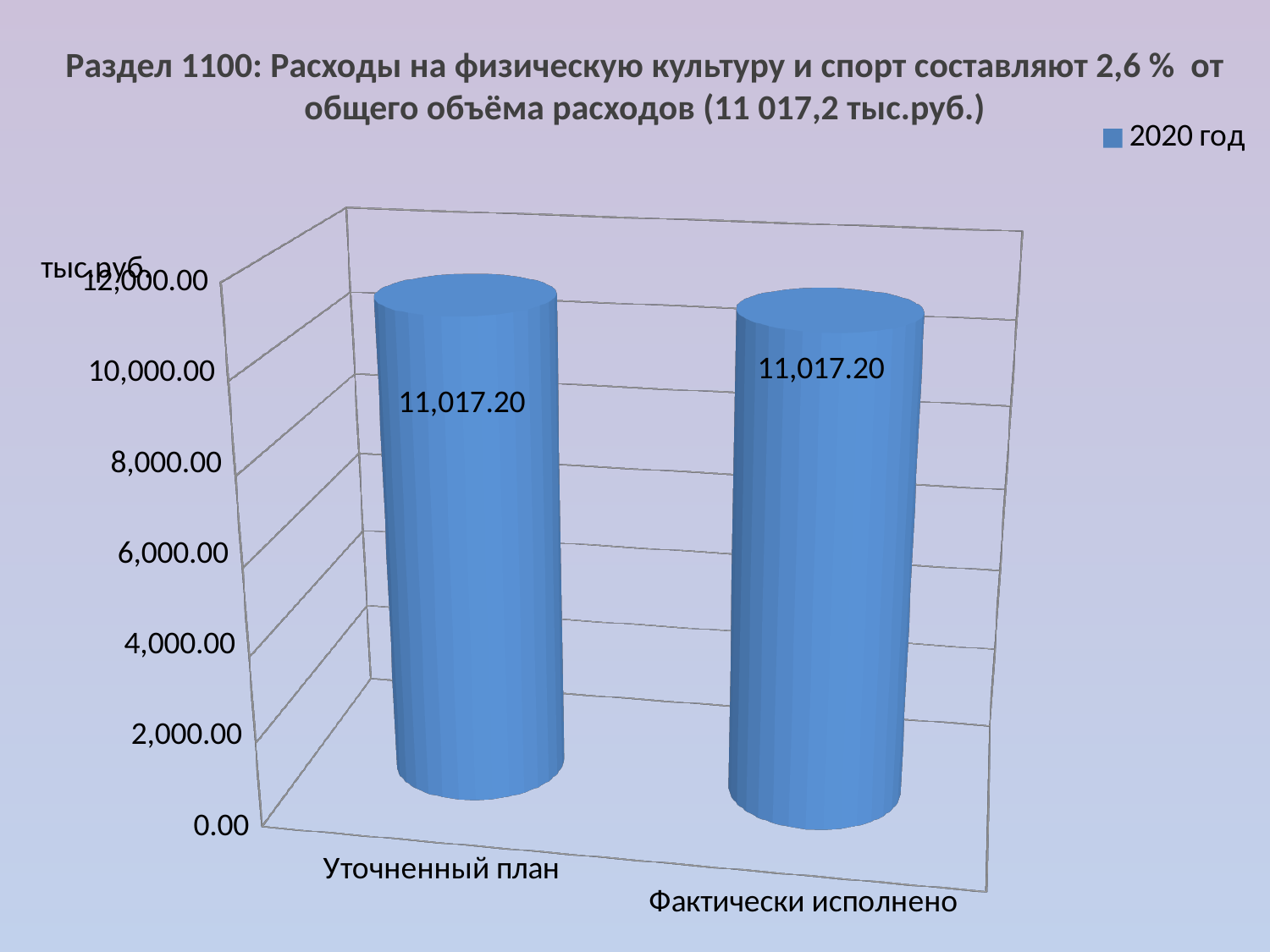
What series name is shown in the legend? 2020 год Do the values rise, fall or stay the same from Уточненный план to Фактически исполнено? stay the same What unit is written next to the vertical axis? тыс.руб What is the value for Фактически исполнено? 11,017.20 Is the value for Уточненный план greater or less than 12,000.00? less What is the difference between the values for Уточненный план and Фактически исполнено? 0.00 What is the value for Уточненный план? 11,017.20 How many categories are shown on the x axis? 2 How many series does the legend list? 1 Is the value for Фактически исполнено greater or less than 10,000.00? greater What kind of chart is shown on the slide? bar chart